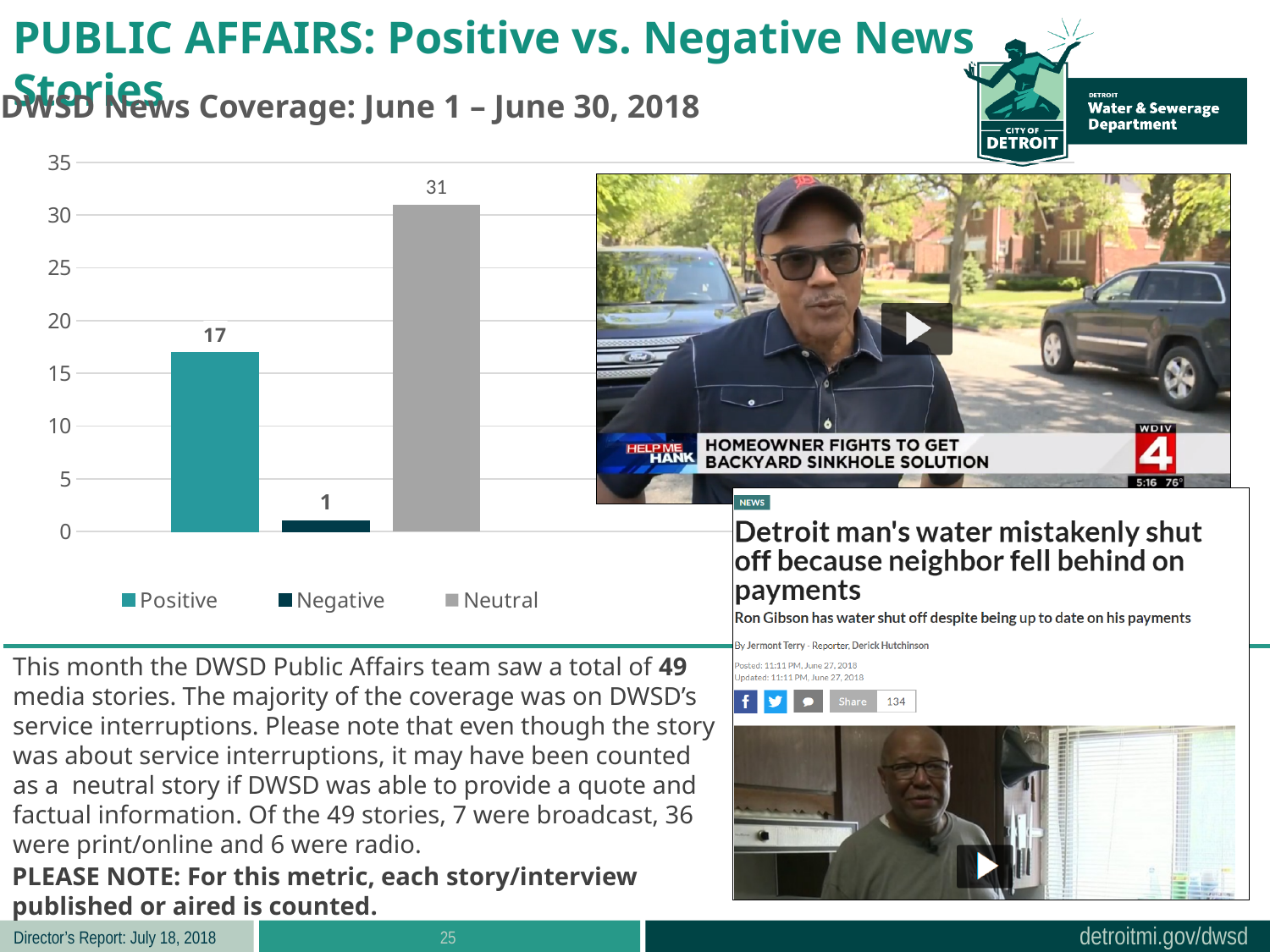
Which is larger, the Positive value or the Neutral value? Neutral What is the subtitle shown above the chart? DWSD News Coverage: June 1 – June 30, 2018 How many series does the legend list? 3 What kind of chart is shown on the slide? Bar chart What is the difference between the Neutral and Positive values? 14 Which category has the lowest value in the chart? Negative What is the difference between the Positive and Negative values? 16 What is the value for Positive news stories in the chart? 17 Is the value for Neutral greater or less than 30? greater Which category has the highest value in the chart? Neutral What is the value for Neutral news stories in the chart? 31 What is the value for Negative news stories in the chart? 1